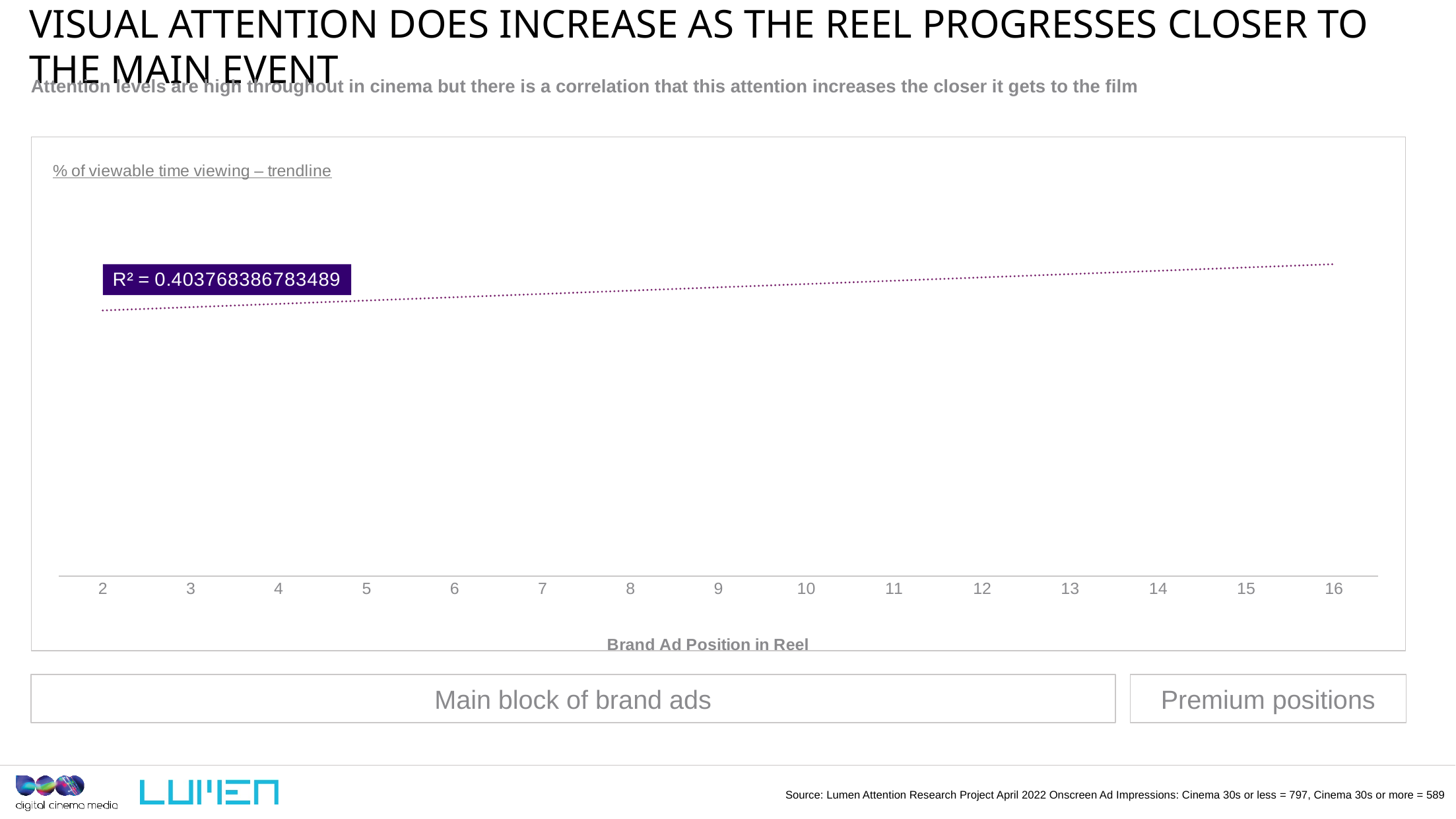
What is the first position labelled on the x axis? 2 What is the title of the x axis? Brand Ad Position in Reel What kind of chart is shown on the slide? line chart (trendline) What is the title of the chart? % of viewable time viewing – trendline What is the last position labelled on the x axis? 16 How many brand ad positions are labelled on the x axis of the chart? 15 Does the trendline rise or fall as the brand ad position in the reel increases from 2 to 16? rise At which brand ad position is the trendline at its lowest? 2 Is the trendline higher at position 16 or at position 2? 16 What is the R² value shown on the chart? R² = 0.403768386783489 At which brand ad position is the trendline at its highest? 16